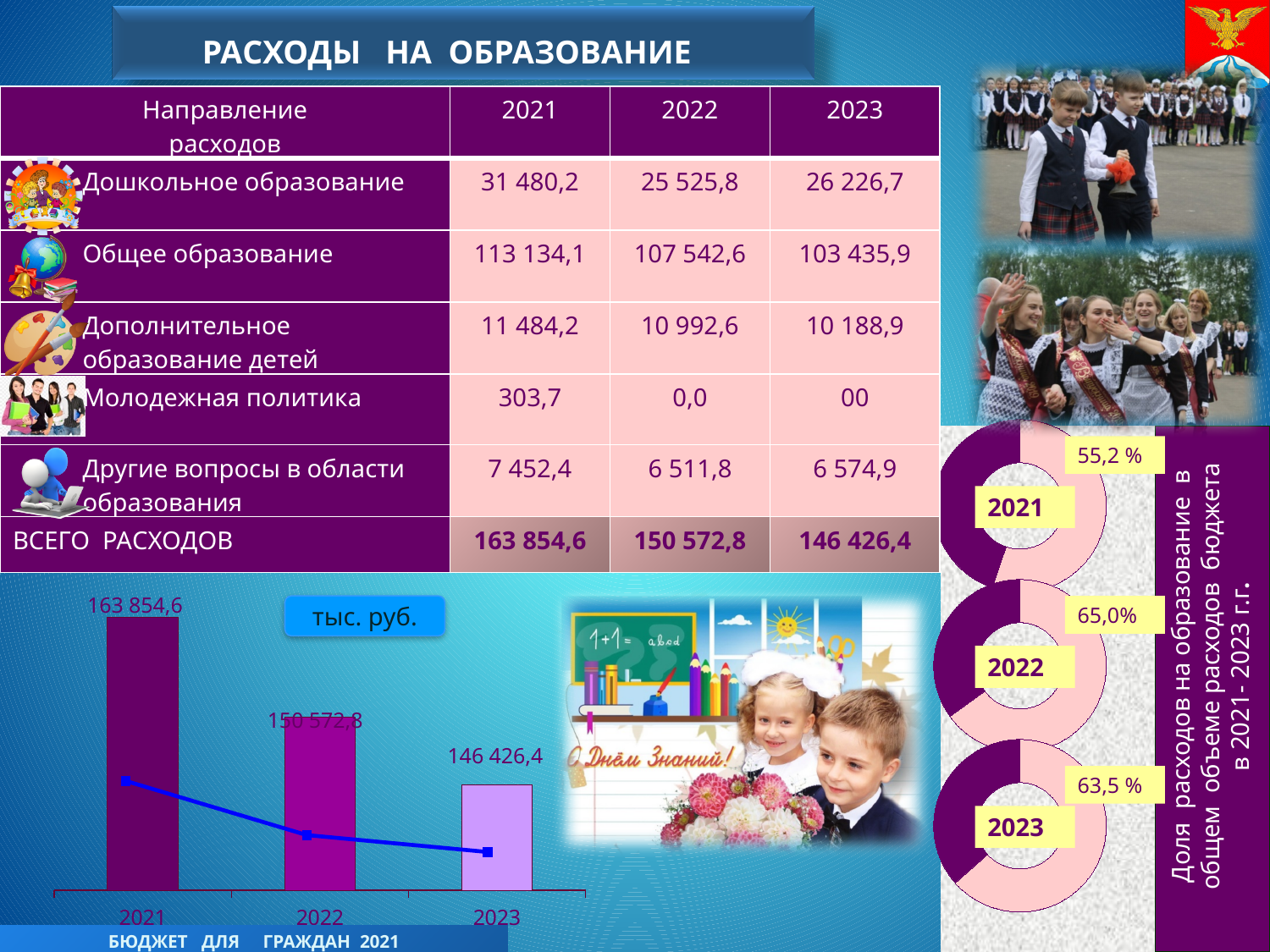
In the bar chart at the bottom left, what is the difference between the values for 2022 and 2023? 4 146,4 In the donut charts on the right, what share is shown for 2022? 65,0% In the bar chart at the bottom left, which is larger, the value for 2021 or the value for 2023? 2021 How many bars are shown in the bar chart at the bottom left? 3 In the bar chart at the bottom left, what is the difference between the values for 2021 and 2022? 13 281,8 What unit is shown for the values in the bar chart at the bottom left? тыс. руб. In the bar chart at the bottom left, what is the value for 2021? 163 854,6 In the bar chart at the bottom left, which year has the lowest value? 2023 In the bar chart at the bottom left, which year has the highest value? 2021 In the bar chart at the bottom left, what is the value for 2023? 146 426,4 In the bar chart at the bottom left, what is the value for 2022? 150 572,8 Do the values in the bar chart at the bottom left rise or fall from 2021 to 2023? fall